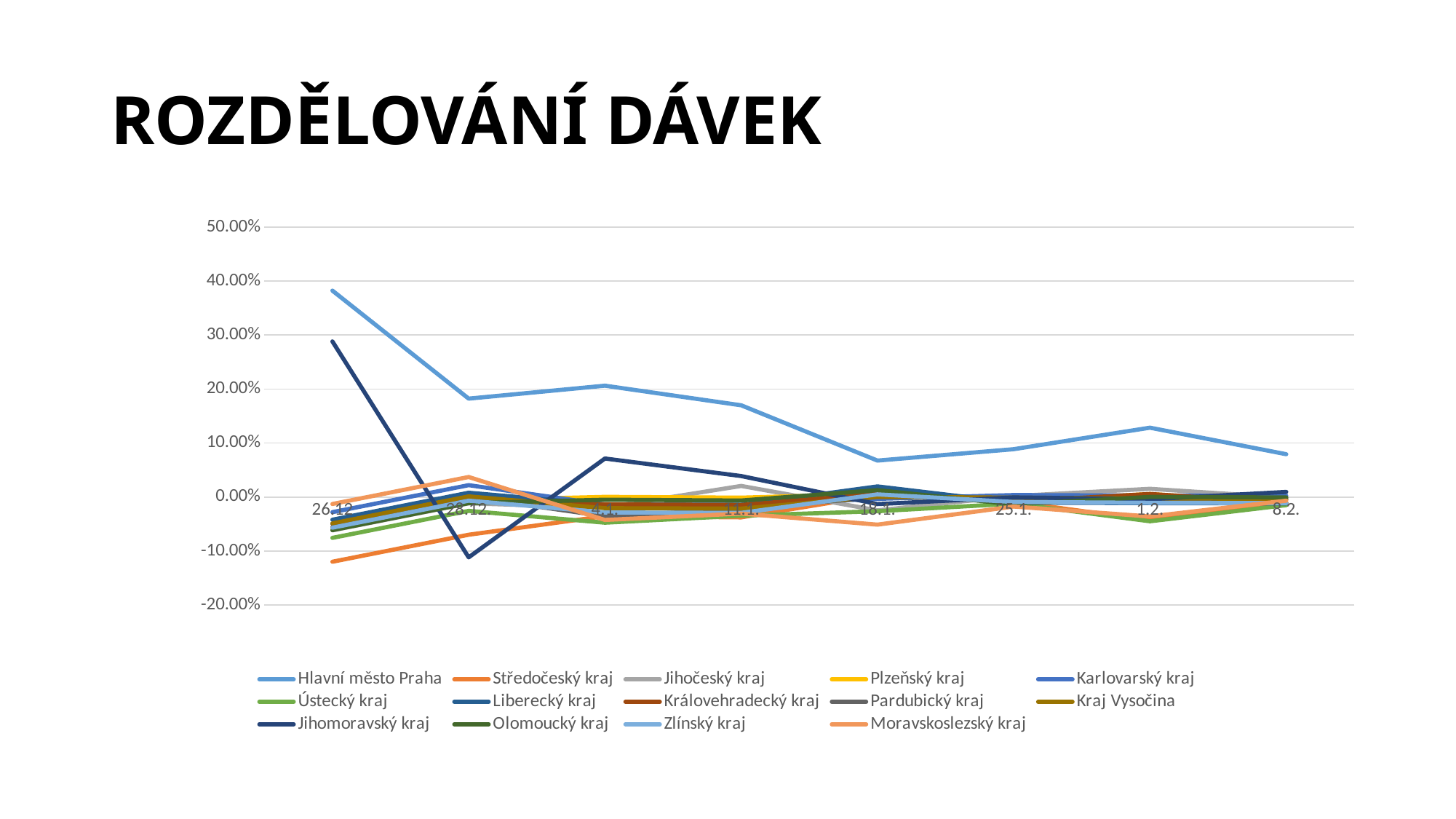
What kind of chart is shown on the slide? line chart Is the value for Hlavní město Praha at 8.2. greater or less than 10.00%? less What is the title of the slide containing the chart? ROZDĚLOVÁNÍ DÁVEK Is the value for Jihomoravský kraj at 28.12. greater or less than 0.00%? less Is the value for Hlavní město Praha at 26.12. greater or less than 30.00%? greater How many series does the legend list? 14 Which series has the highest value at 26.12.? Hlavní město Praha Which series has the lowest value at 26.12.? Středočeský kraj How many dates are shown along the x axis? 8 At 4.1., which is larger: the value for Hlavní město Praha or for Jihomoravský kraj? Hlavní město Praha Does the line for Hlavní město Praha rise or fall from 26.12. to 18.1.? fall